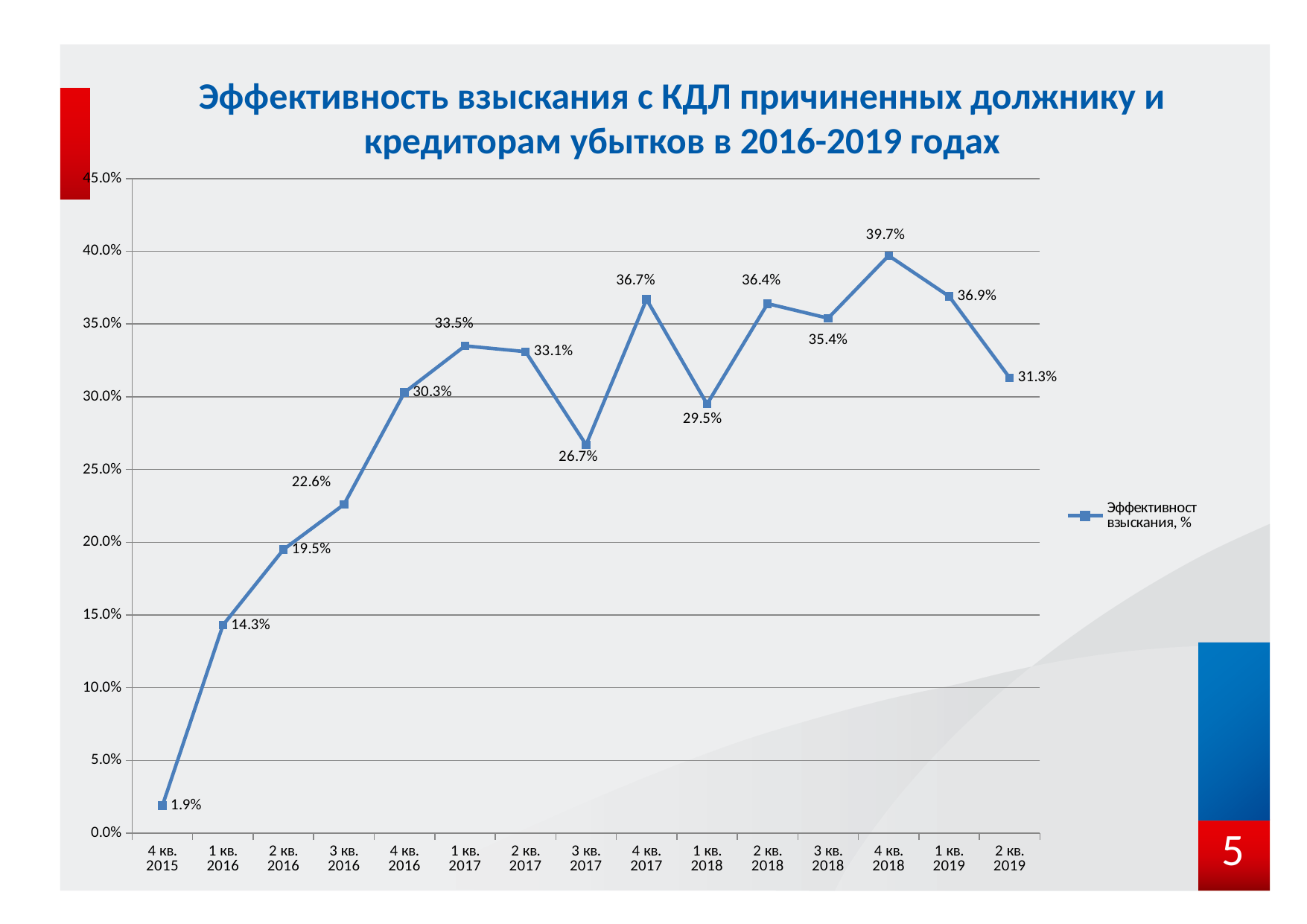
How many data points are plotted on the chart? 15 What kind of chart is shown on the slide? line chart Is the value for 3 кв. 2016 greater or less than 25.0%? less What is the difference between the values for 4 кв. 2018 and 2 кв. 2019? 8.4% Do the values rise or fall from 4 кв. 2015 to 4 кв. 2016? rise Which quarter has the highest value? 4 кв. 2018 Which quarter has the lowest value? 4 кв. 2015 Which is larger, the value for 4 кв. 2017 or the value for 1 кв. 2018? 4 кв. 2017 What is the value for 4 кв. 2018? 39.7% What is the value for 2 кв. 2019? 31.3% What is the value for 1 кв. 2016? 14.3% What is the value for 3 кв. 2017? 26.7%